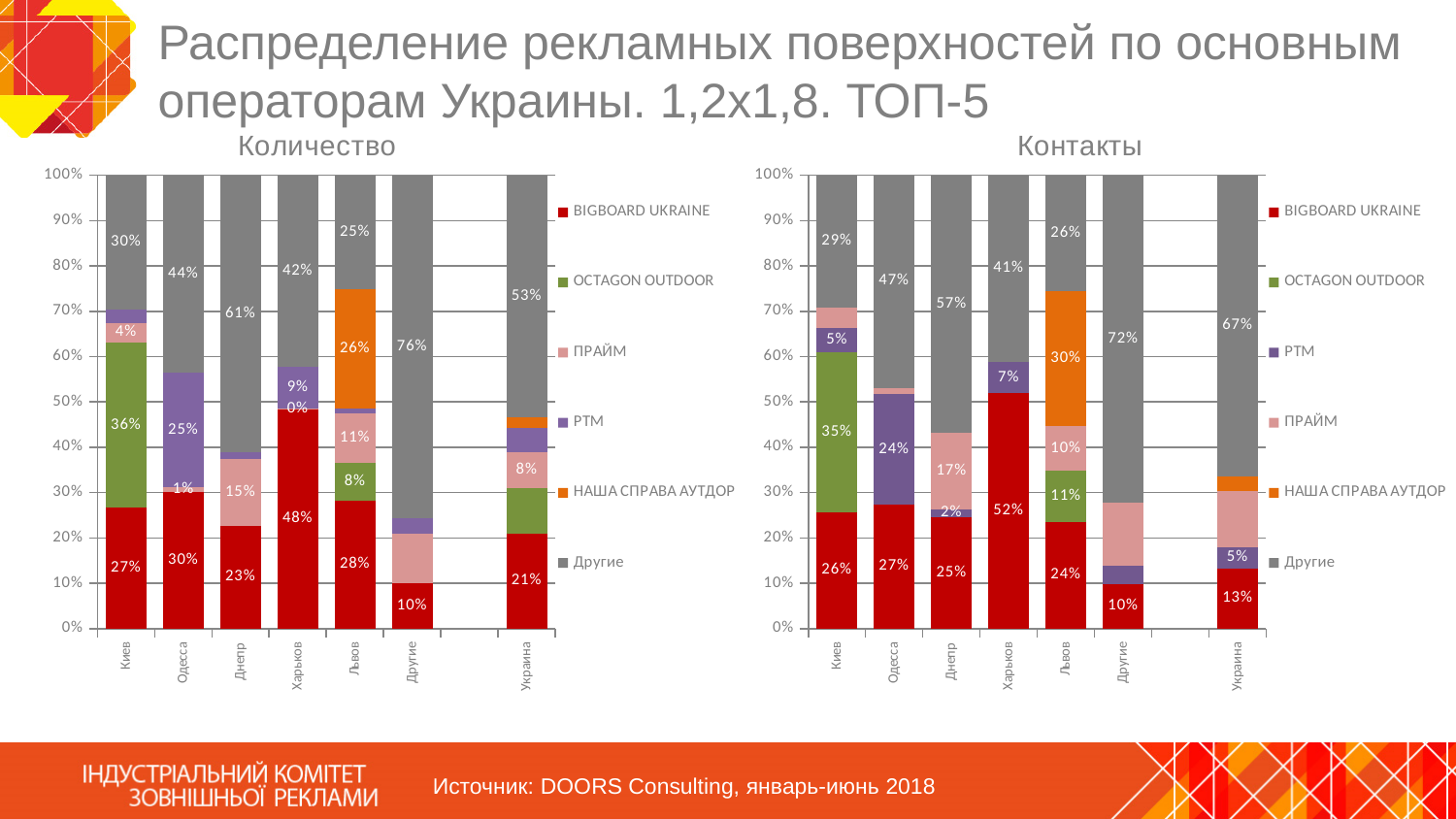
In the 'Контакты' chart, which category has the lowest BIGBOARD UKRAINE share? Другие In the 'Количество' chart, what is the OCTAGON OUTDOOR share for Киев? 36% In the 'Контакты' chart, what is the НАША СПРАВА АУТДОР share for Львов? 30% In the 'Количество' chart, what is the 'Другие' share for the 'Другие' category? 76% In the 'Контакты' chart, which is larger: the OCTAGON OUTDOOR share for Киев or the РТМ share for Одесса? OCTAGON OUTDOOR share for Киев In the 'Контакты' chart, what is the BIGBOARD UKRAINE share for Харьков? 52% How many series does the legend of the 'Контакты' chart list? 6 How many categories are shown on the x axis of the 'Количество' chart? 7 In the 'Количество' chart, what is the BIGBOARD UKRAINE share for Харьков? 48% In the 'Количество' chart, what is the difference between the BIGBOARD UKRAINE shares for Одесса and Днепр? 7% In the 'Контакты' chart, what is the 'Другие' share for Украина? 67% In the 'Количество' chart, which category has the highest BIGBOARD UKRAINE share? Харьков